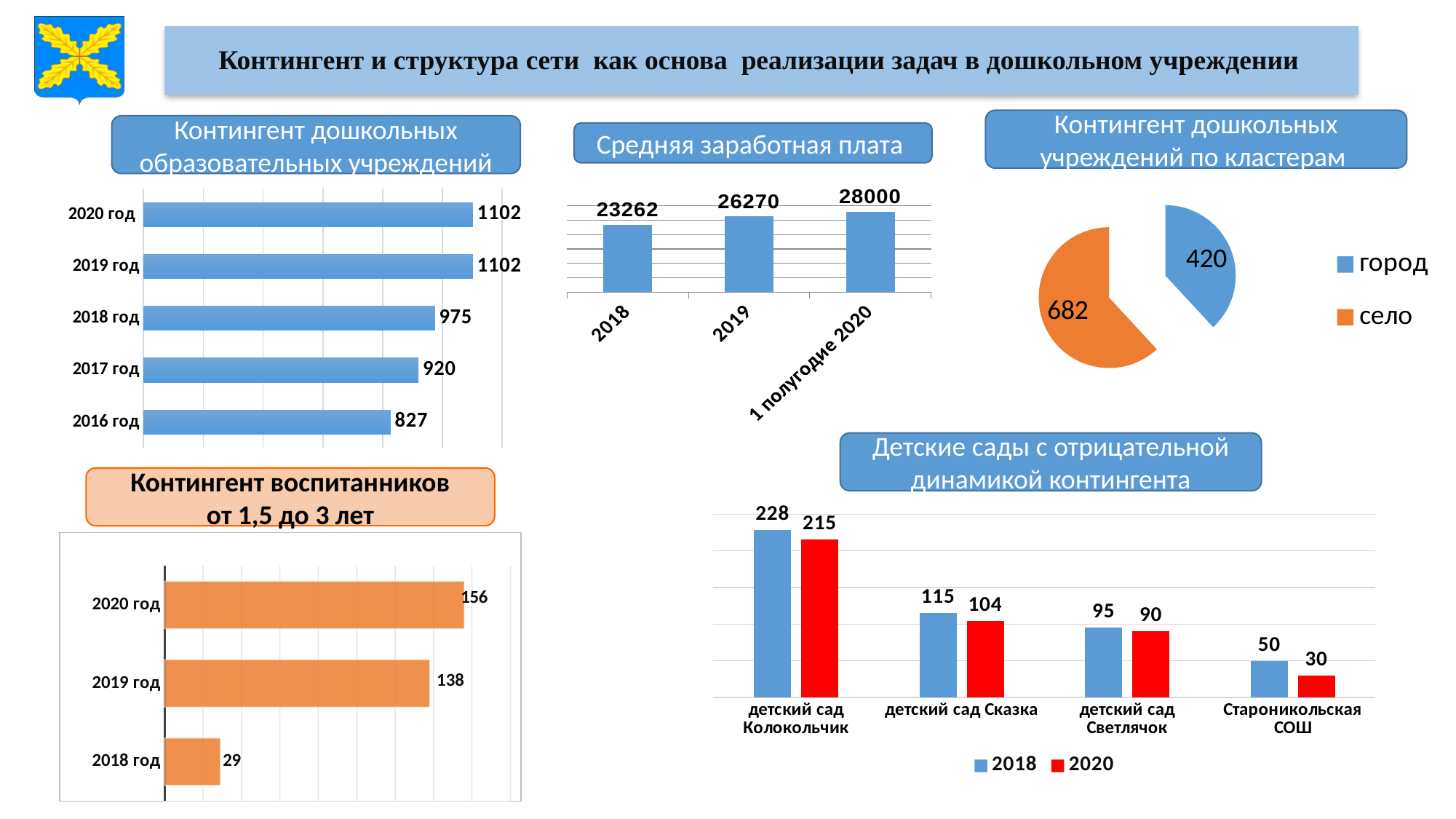
In the chart 'Контингент дошкольных образовательных учреждений', what is the difference between the values for 2017 год and 2016 год? 93 In the chart 'Контингент воспитанников от 1,5 до 3 лет', what is the difference between 2020 год and 2018 год? 127 In the pie chart 'Контингент дошкольных учреждений по кластерам', what is the value for село? 682 In the chart 'Детские сады с отрицательной динамикой контингента', what is the 2020 value for Староникольская СОШ? 30 In the pie chart 'Контингент дошкольных учреждений по кластерам', what is the total of город and село? 1102 In the chart 'Контингент дошкольных образовательных учреждений', which year has the lowest value? 2016 год In the chart 'Средняя заработная плата', do the values rise or fall from 2018 to 1 полугодие 2020? rise In the chart 'Средняя заработная плата', what is the value for 2019? 26270 In the chart 'Контингент дошкольных образовательных учреждений', what is the value for 2018 год? 975 In the chart 'Средняя заработная плата', how many bars are plotted? 3 In the chart 'Контингент воспитанников от 1,5 до 3 лет', what is the value for 2019 год? 138 In the chart 'Детские сады с отрицательной динамикой контингента', how many series does the legend list? 2